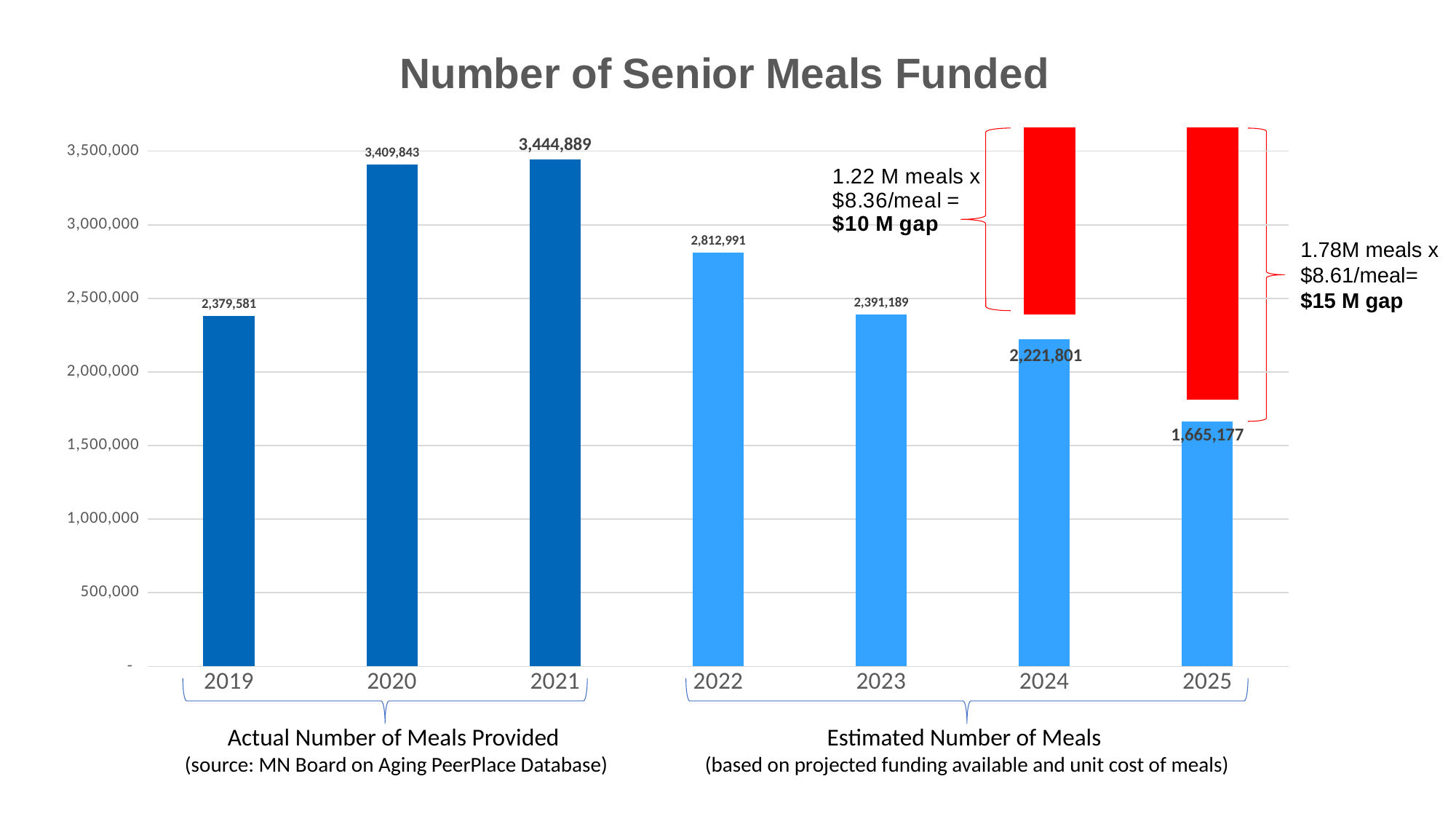
What is the number of senior meals funded in 2021? 3,444,889 Which year has the highest number of senior meals funded? 2021 What is the number of senior meals funded in 2019? 2,379,581 Which year has more meals funded, 2023 or 2024? 2023 What kind of chart is shown on the slide? bar chart What is the estimated number of meals for 2025? 1,665,177 Is the value for 2022 greater or less than 3,000,000? less Which year has the lowest number of senior meals funded? 2025 How many years are shown on the x axis of the chart? 7 What is the estimated number of meals for 2022? 2,812,991 What is the difference between the number of meals in 2021 and 2020? 35,046 What is the title of the chart? Number of Senior Meals Funded